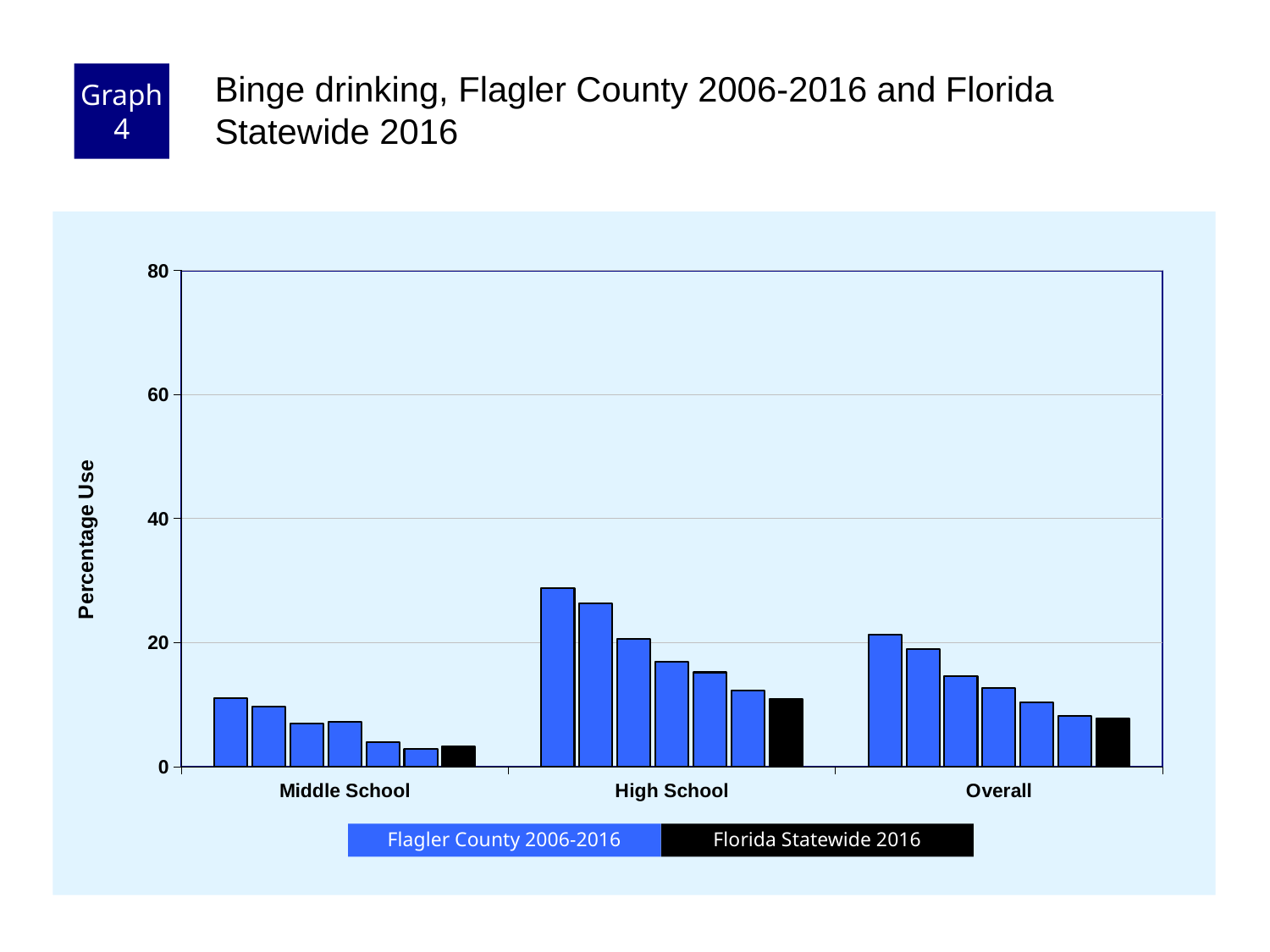
Is the Florida Statewide 2016 value for High School greater or less than 20? less Which is larger: the Florida Statewide 2016 value for High School or for Middle School? High School How many school-level categories are shown on the x axis? 3 Is the Florida Statewide 2016 value for Overall greater or less than 20? less Which category has the shortest bars overall? Middle School Is the tallest Flagler County bar for Middle School greater or less than 20? less Which category has the tallest bars overall? High School How many series does the legend list? 2 What is the label on the y axis? Percentage Use Within each category, do the Flagler County 2006-2016 bars rise or fall from left to right? fall What kind of chart is shown on the slide? bar chart